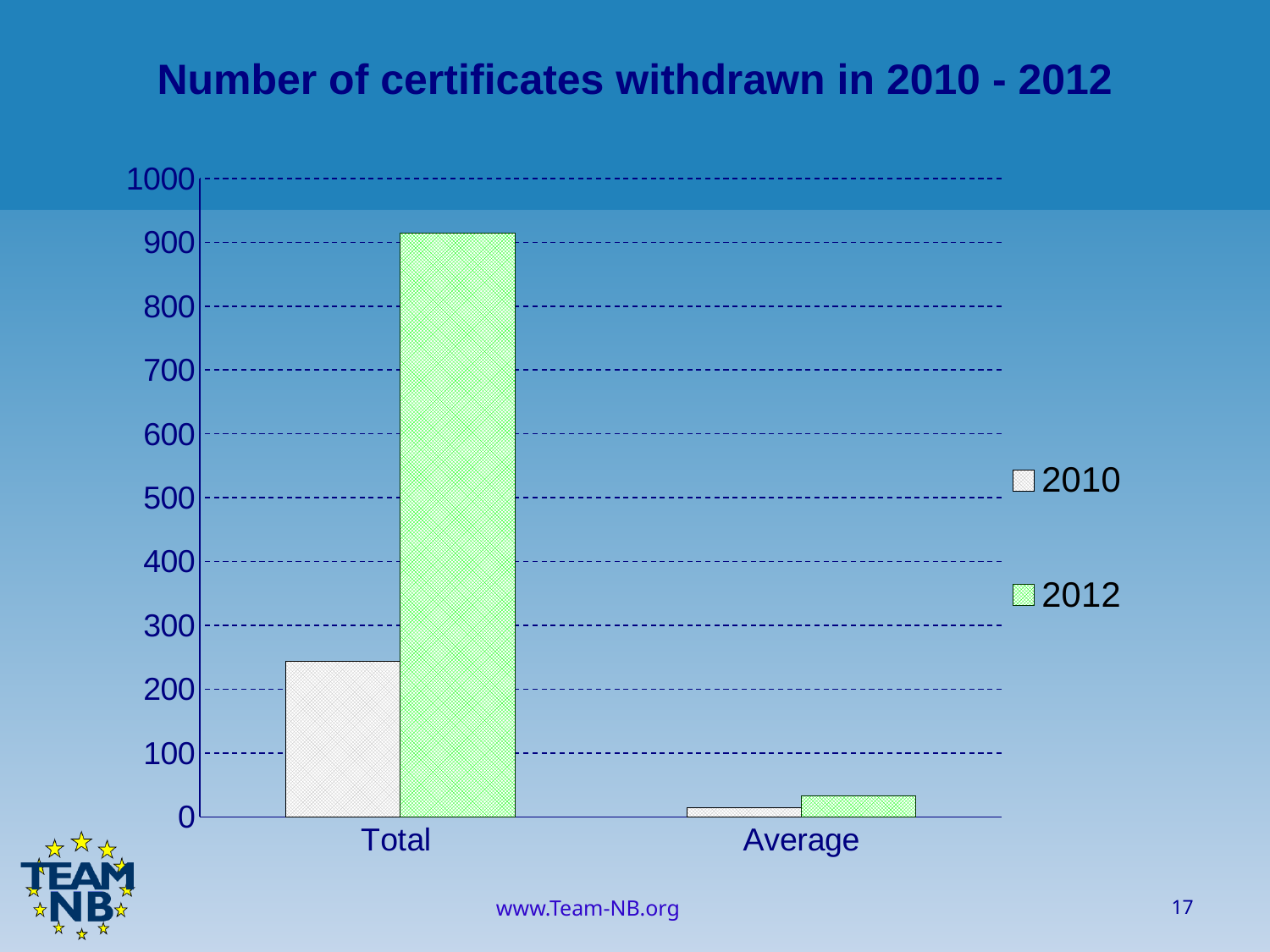
How many categories are shown on the x axis? 2 Is the value for Total in 2010 greater or less than 200? greater Which bar is the highest in the chart? Total, 2012 What kind of chart is shown on the slide? bar chart What is the title of the chart? Number of certificates withdrawn in 2010 - 2012 Is the value for Total in 2010 greater or less than 300? less Which bar is the lowest in the chart? Average, 2010 Is the value for Total in 2012 greater or less than 800? greater Which years are listed in the legend? 2010 and 2012 Which is larger for Total: the 2010 value or the 2012 value? 2012 How many series does the legend list? 2